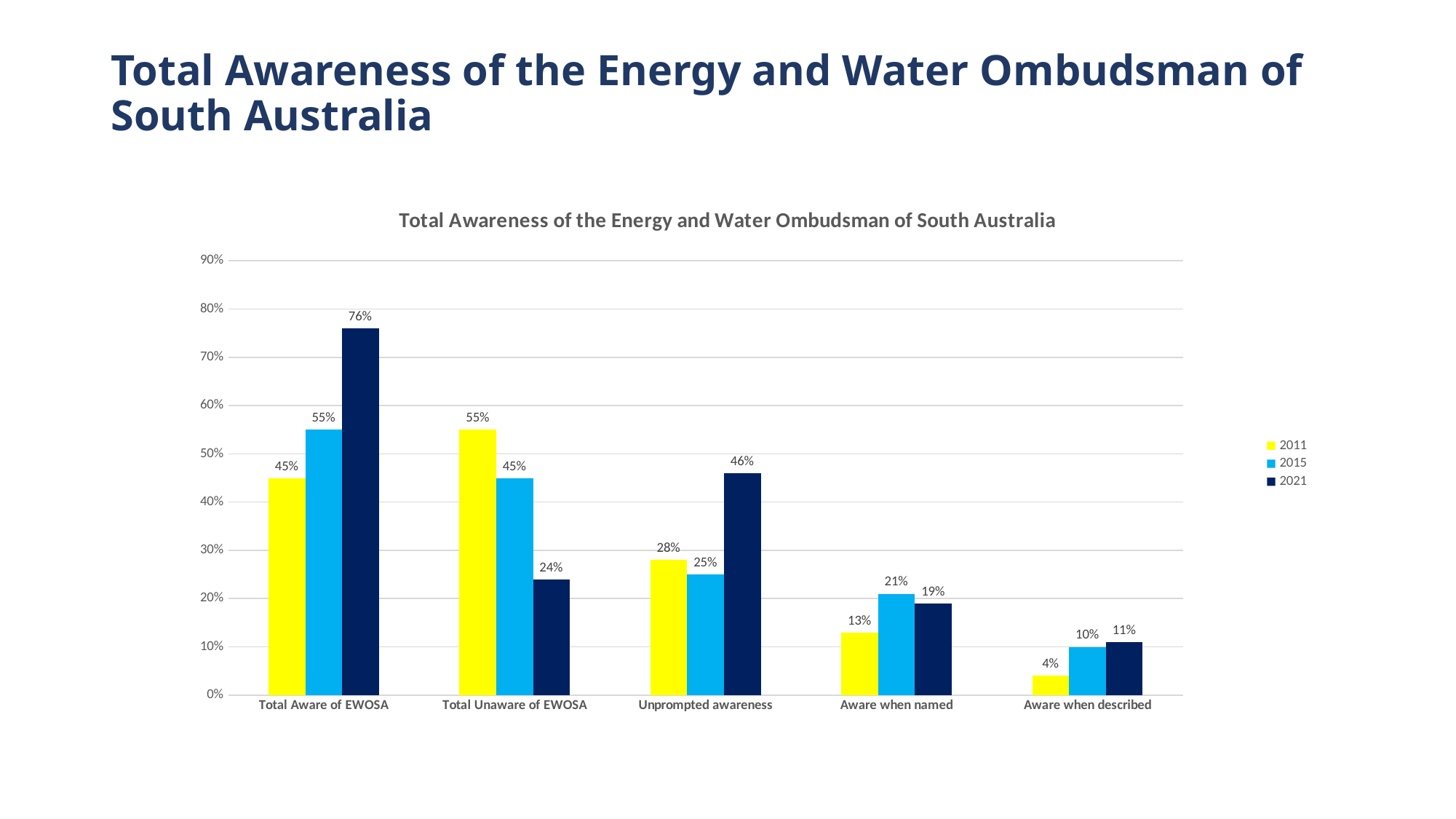
What is the difference between the 2021 and 2011 values for Total Aware of EWOSA? 31% What is the 2015 value for Aware when named? 21% Which category has the highest 2021 value? Total Aware of EWOSA Which is larger for Total Unaware of EWOSA: the 2011 value or the 2021 value? 2011 What kind of chart is shown on the slide? Bar chart What is the 2011 value for Unprompted awareness? 28% How many categories are shown on the x axis? 5 Which category has the lowest 2011 value? Aware when described How many series does the legend list? 3 What is the 2011 value for Aware when described? 4% Which series is shown in yellow in the legend? 2011 What is the 2021 value for Total Aware of EWOSA? 76%